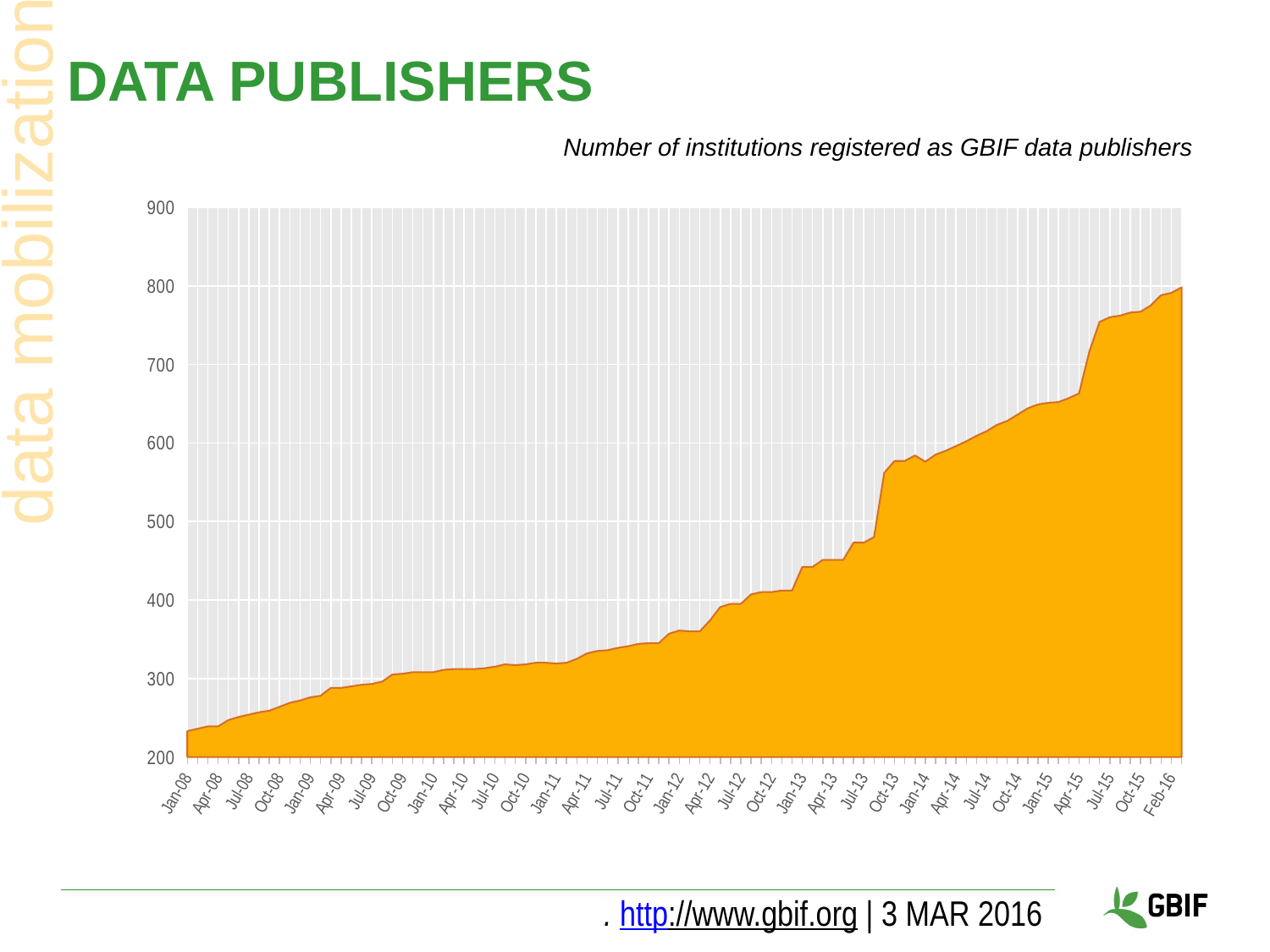
Is the value for Jul-15 greater or less than 700? greater What does the chart measure, according to its subtitle? Number of institutions registered as GBIF data publishers Which date on the x axis has the lowest number of data publishers? Jan-08 Which is larger, the value for Jan-14 or the value for Jan-11? Jan-14 What kind of chart is shown on the slide? area chart Is the value for Jan-12 greater or less than 400? less Is the value for Feb-16 greater or less than 700? greater Do the values rise or fall from Jan-08 to Feb-16? rise Which date on the x axis has the highest number of data publishers? Feb-16 What is the highest value shown on the y axis? 900